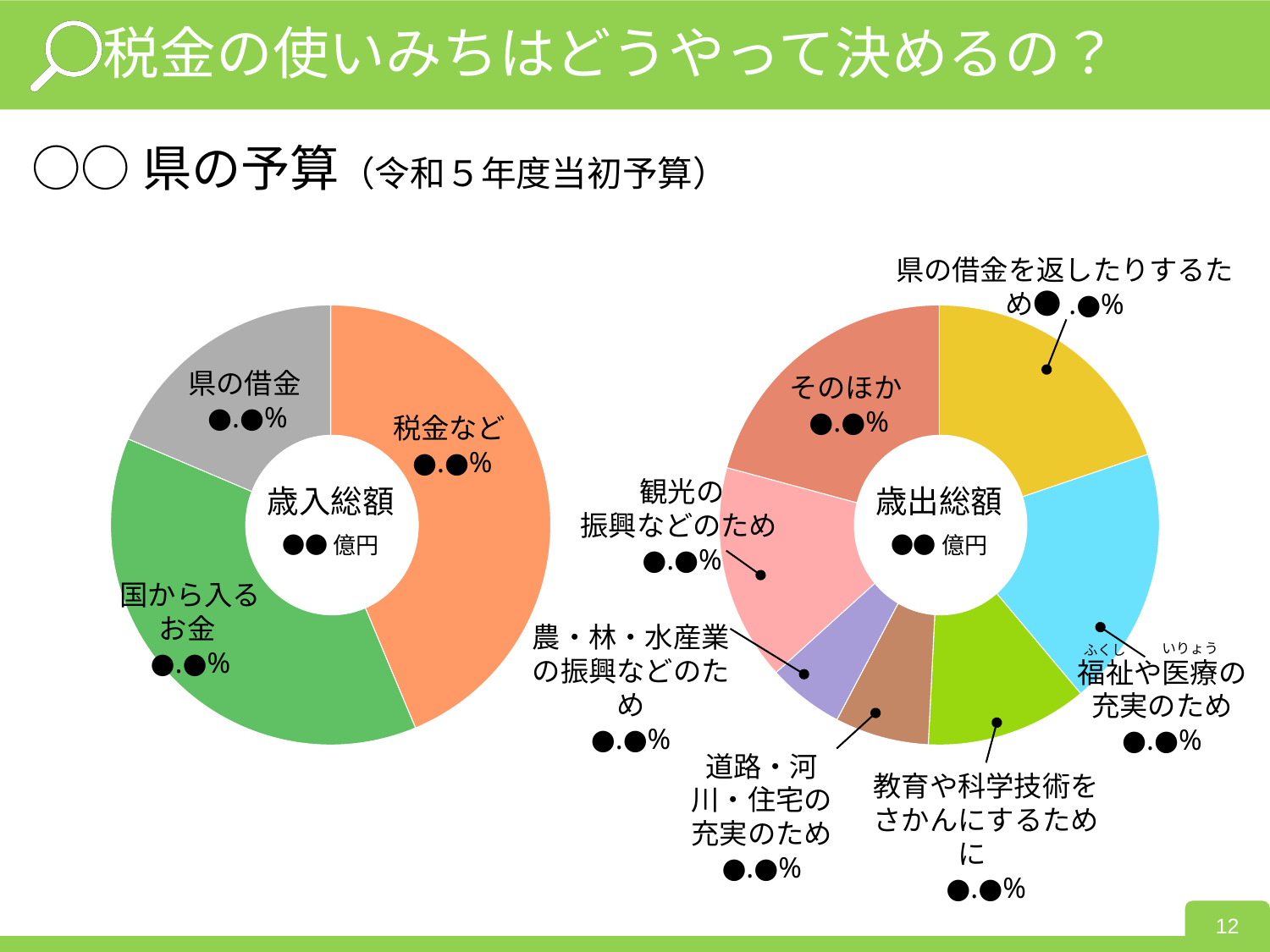
What is the heading above the two charts on the slide? ○○県の予算（令和５年度当初予算） In the left chart (歳入総額), how many slices are there? 3 What kind of chart is the left chart labelled 歳入総額? Pie chart (donut) In the left chart (歳入総額), which category has the largest slice? 税金など In the left chart (歳入総額), which slice is larger: 国から入るお金 or 県の借金? 国から入るお金 In the right chart (歳出総額), which slice is larger: 観光の振興などのため or 農・林・水産業の振興などのため? 観光の振興などのため In the left chart (歳入総額), which category has the smallest slice? 県の借金 In the right chart (歳出総額), which category has the smallest slice? 農・林・水産業の振興などのため In the right chart (歳出総額), which slice is larger: 福祉や医療の充実のため or 道路・河川・住宅の充実のため? 福祉や医療の充実のため What kind of chart is the right chart labelled 歳出総額? Pie chart (donut) What label is written in the centre of the right chart? 歳出総額 ●●億円 In the right chart (歳出総額), how many slices are there? 7